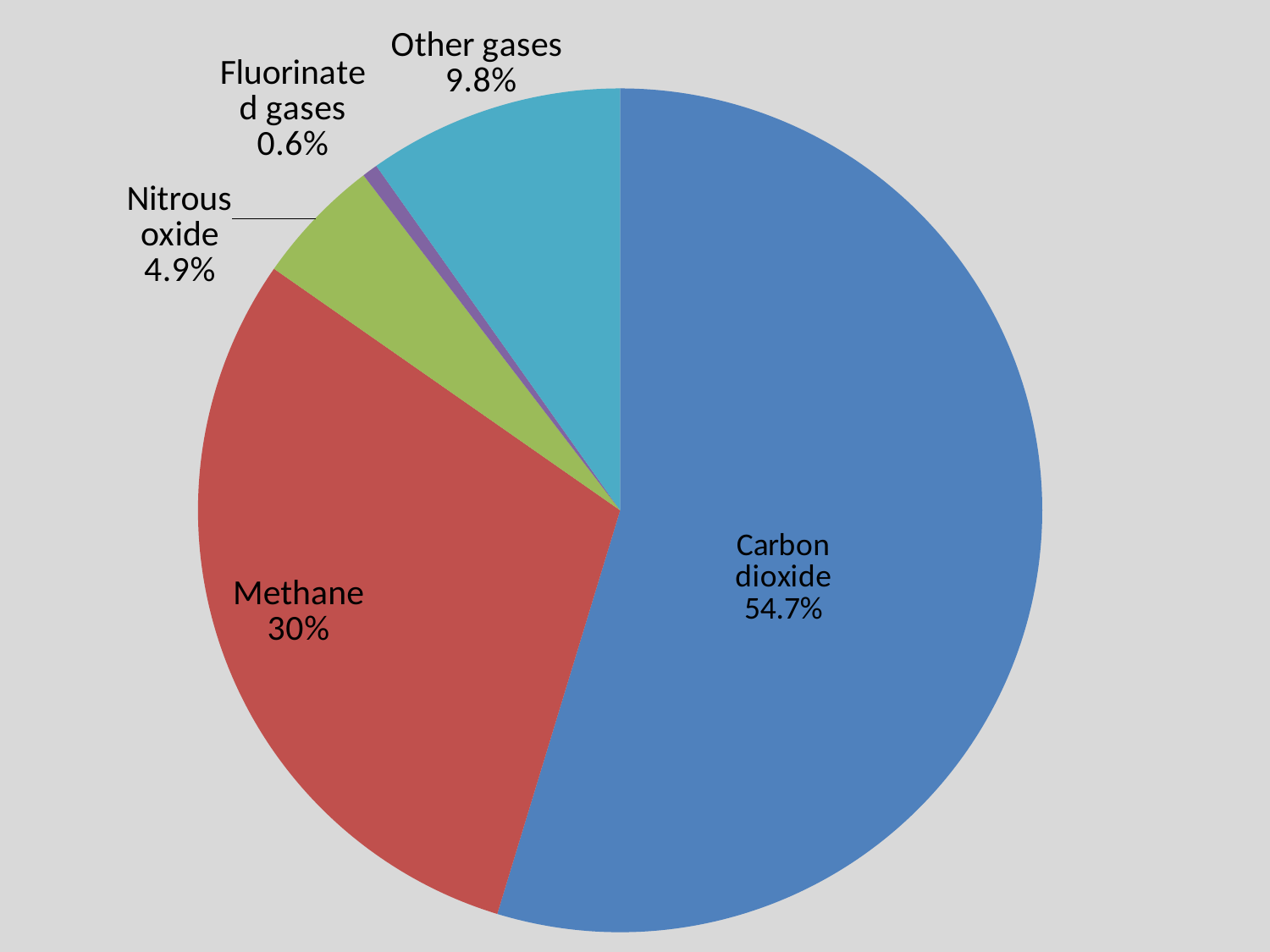
Which slice of the pie is the largest? Carbon dioxide What is the value shown for Other gases? 9.8% What is the value shown for Nitrous oxide? 4.9% What is the value shown for Fluorinated gases? 0.6% What is the value shown for Methane? 30% What colour is the Methane slice? red Which is larger, Other gases or Nitrous oxide? Other gases What is the difference between the Carbon dioxide and Methane shares? 24.7% How many slices does the pie chart have? 5 What share of the pie does Carbon dioxide have? 54.7% Which slice of the pie is the smallest? Fluorinated gases What kind of chart is shown on the slide? pie chart